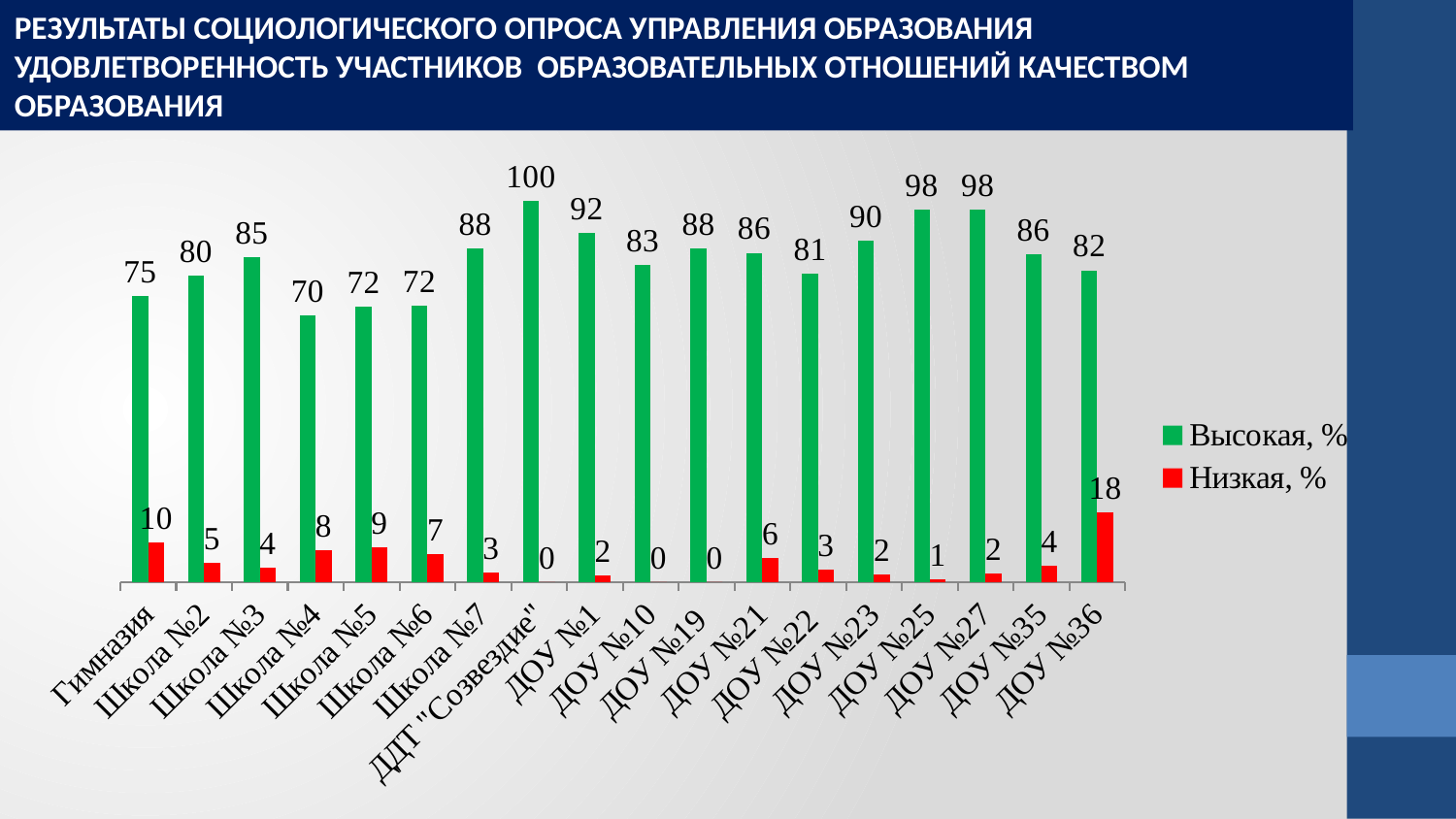
What is the value of "Высокая, %" for ДОУ №1? 92 What kind of chart is shown on the slide? Bar chart Which category has the highest value of "Высокая, %"? ДДТ "Созвездие" Which category has the lowest value of "Высокая, %"? Школа №4 What is the value of "Низкая, %" for ДОУ №36? 18 Which category has the highest value of "Низкая, %"? ДОУ №36 How many series does the legend list? 2 How many categories are shown on the x axis? 18 What is the value of "Высокая, %" for Школа №3? 85 What colour are the bars for the "Низкая, %" series? Red What is the difference between the "Высокая, %" values for ДОУ №25 and Гимназия? 23 Which is larger, the "Низкая, %" value for Гимназия or for Школа №5? Гимназия